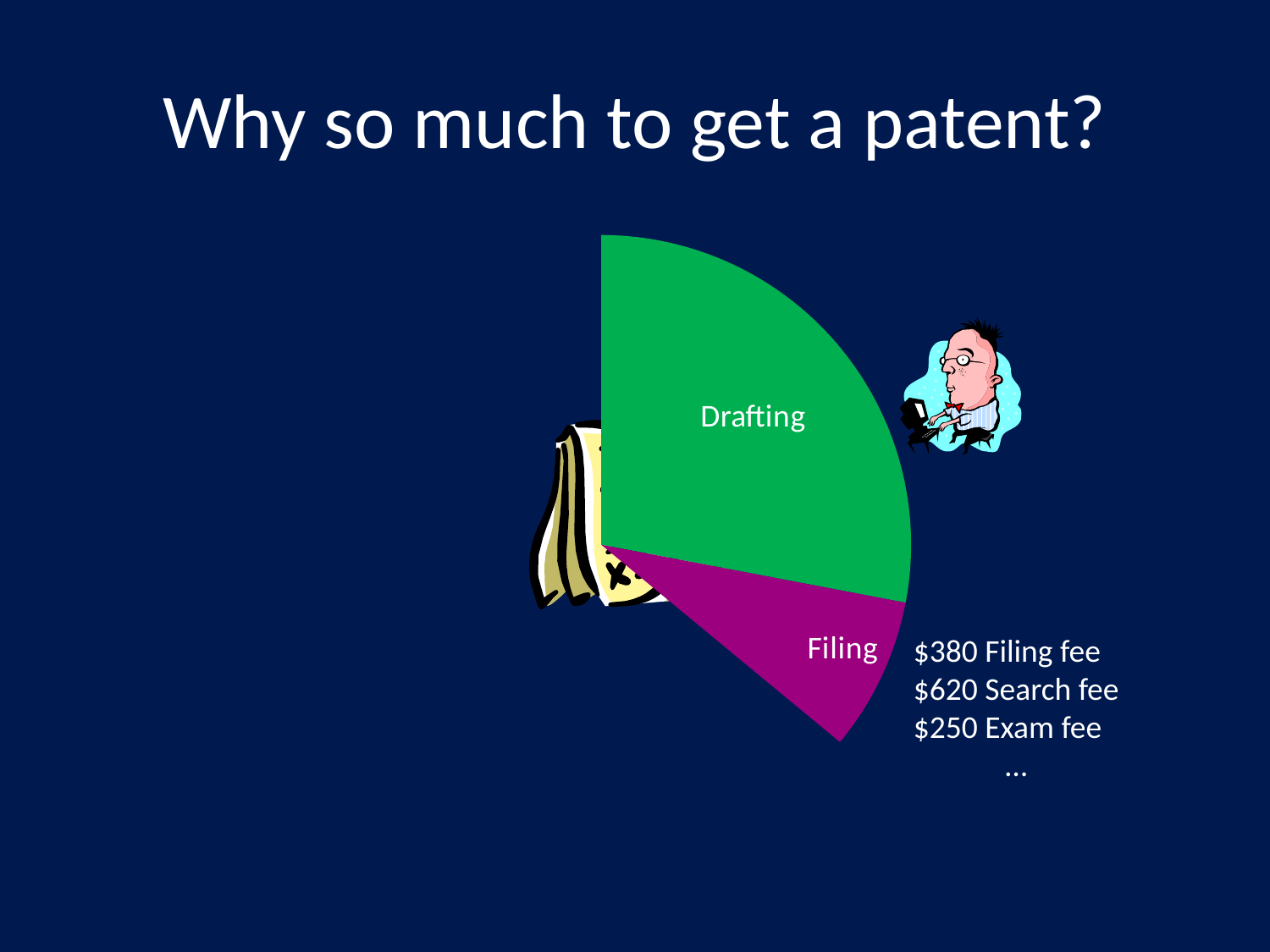
Which labelled slice of the pie chart is the largest? Drafting What colour is the Drafting slice of the pie chart? green What colour is the Filing slice of the pie chart? magenta Which labelled slice of the pie chart is larger, Drafting or Filing? Drafting Which labelled slice of the pie chart is the smallest? Filing What kind of chart is shown on the slide? pie chart How many labelled slices are visible in the pie chart? 2